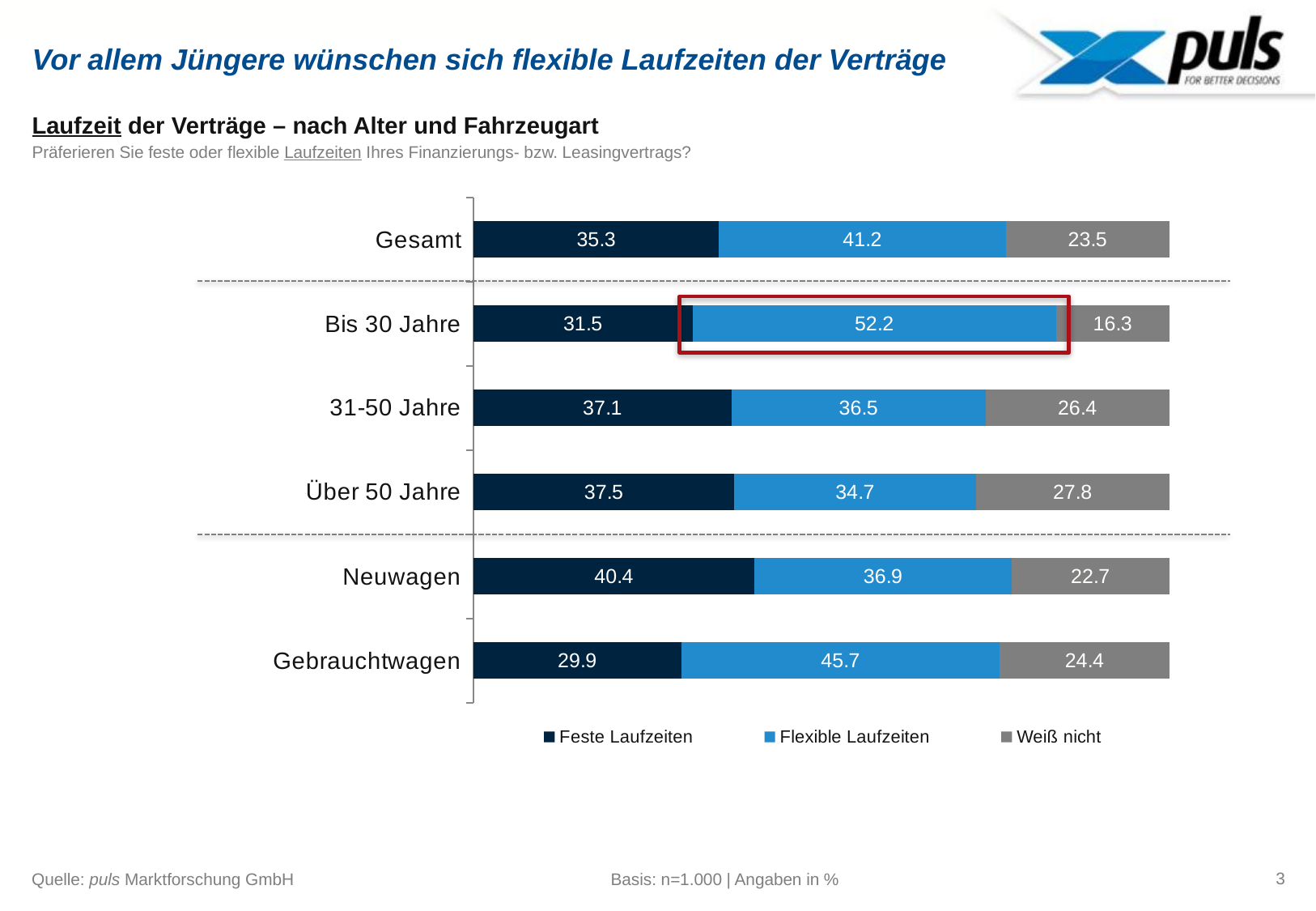
How many series does the legend list? 3 What is the value for Flexible Laufzeiten in the Bis 30 Jahre category? 52.2 What is the value for Feste Laufzeiten in the Gesamt category? 35.3 Which category has the highest value for Flexible Laufzeiten? Bis 30 Jahre Which category has the highest value for Feste Laufzeiten? Neuwagen Which is larger: the Feste Laufzeiten value for Neuwagen or for Gebrauchtwagen? Neuwagen What is the total of the stacked bar for Gebrauchtwagen? 100.0 What is the difference between the Flexible Laufzeiten values for Bis 30 Jahre and Über 50 Jahre? 17.5 What is the value for Weiß nicht in the Über 50 Jahre category? 27.8 What type of chart is shown on the slide? Stacked bar chart How many categories are shown on the chart? 6 Which category has the lowest value for Weiß nicht? Bis 30 Jahre